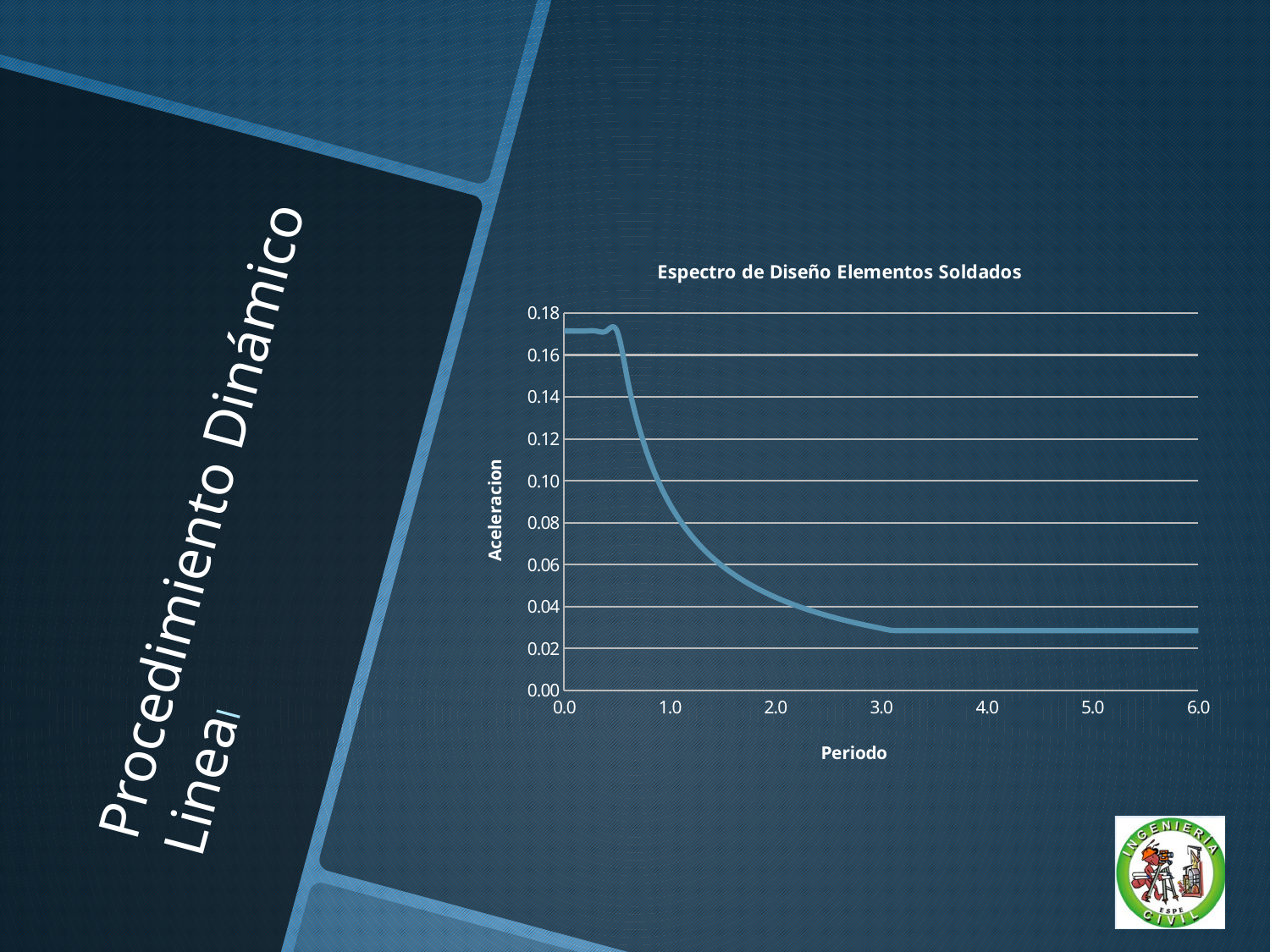
Is the value of Aceleracion at Periodo 0.0 greater or less than 0.16? greater Is the value of Aceleracion at Periodo 1.0 greater or less than 0.06? greater Which has the larger Aceleracion value, Periodo 1.0 or Periodo 4.0? Periodo 1.0 Is the value of Aceleracion at Periodo 1.0 greater or less than 0.12? less What kind of chart is shown on the slide? line chart What is the highest value shown on the vertical axis of the chart? 0.18 What is the label of the vertical axis of the chart? Aceleracion What is the title of the chart? Espectro de Diseño Elementos Soldados Overall, do the values of Aceleracion rise or fall as Periodo increases from 0.0 to 6.0? fall